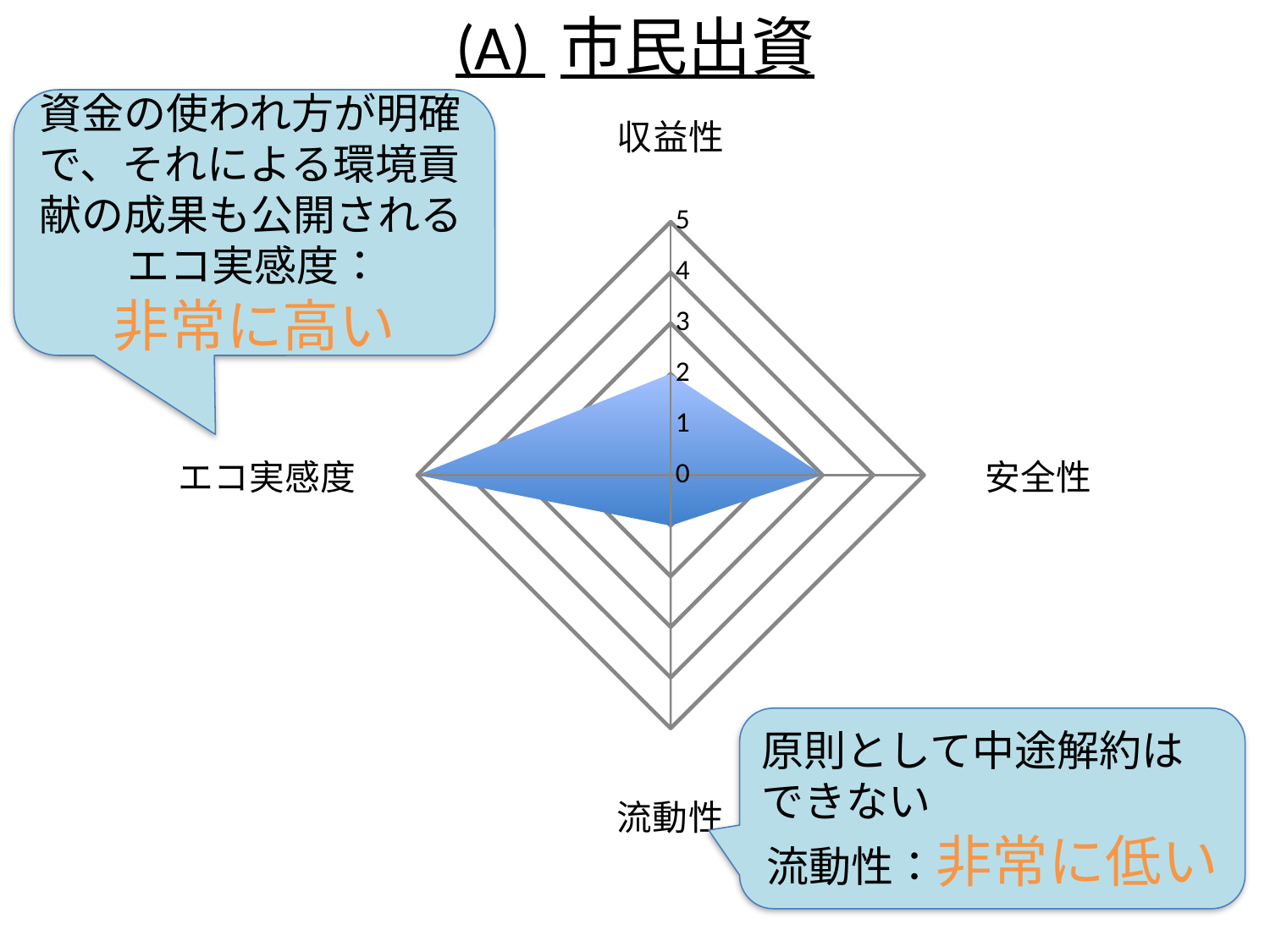
Which is larger on the radar chart, the value for エコ実感度 or the value for 流動性? エコ実感度 Which category has the highest value on the radar chart? エコ実感度 Is the value for 流動性 greater or less than 2? less What is the value for エコ実感度 on the radar chart? 5 What kind of chart is shown on the slide? Radar chart Which category has the lowest value on the radar chart? 流動性 What is the maximum value shown on the radar chart's axis scale? 5 Which is larger on the radar chart, the value for 安全性 or the value for 収益性? 安全性 What is the title of the slide containing the radar chart? (A) 市民出資 What is the value for 収益性 on the radar chart? 2 Is the value for 安全性 greater or less than 2? greater How many categories (axes) does the radar chart have? 4